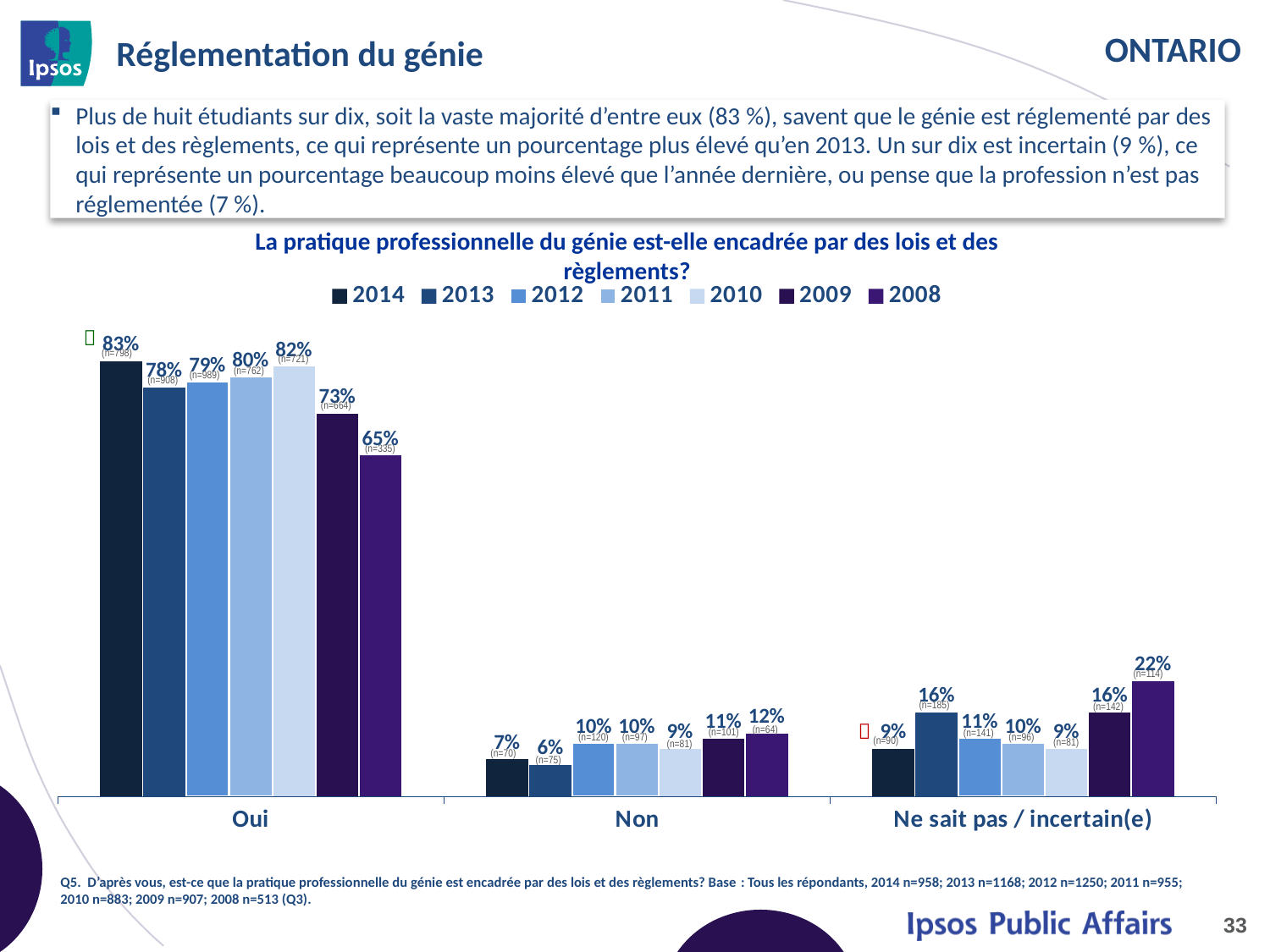
What is the value for 2008 in the "Ne sait pas / incertain(e)" category? 22% What is the value for 2008 in the "Oui" category? 65% What is the difference between the 2014 and 2013 values in the "Oui" category? 5% What is the title of the chart? La pratique professionnelle du génie est-elle encadrée par des lois et des règlements? What percentage of respondents answered "Oui" in 2014? 83% What percentage answered "Non" in 2013? 6% How many series does the legend list? 7 How many response categories are shown on the x axis? 3 Which year has the lowest value in the "Non" category? 2013 Which year has the highest value in the "Oui" category? 2014 What type of chart is shown on the slide? Bar chart Which is larger: the 2013 value or the 2014 value for "Ne sait pas / incertain(e)"? 2013